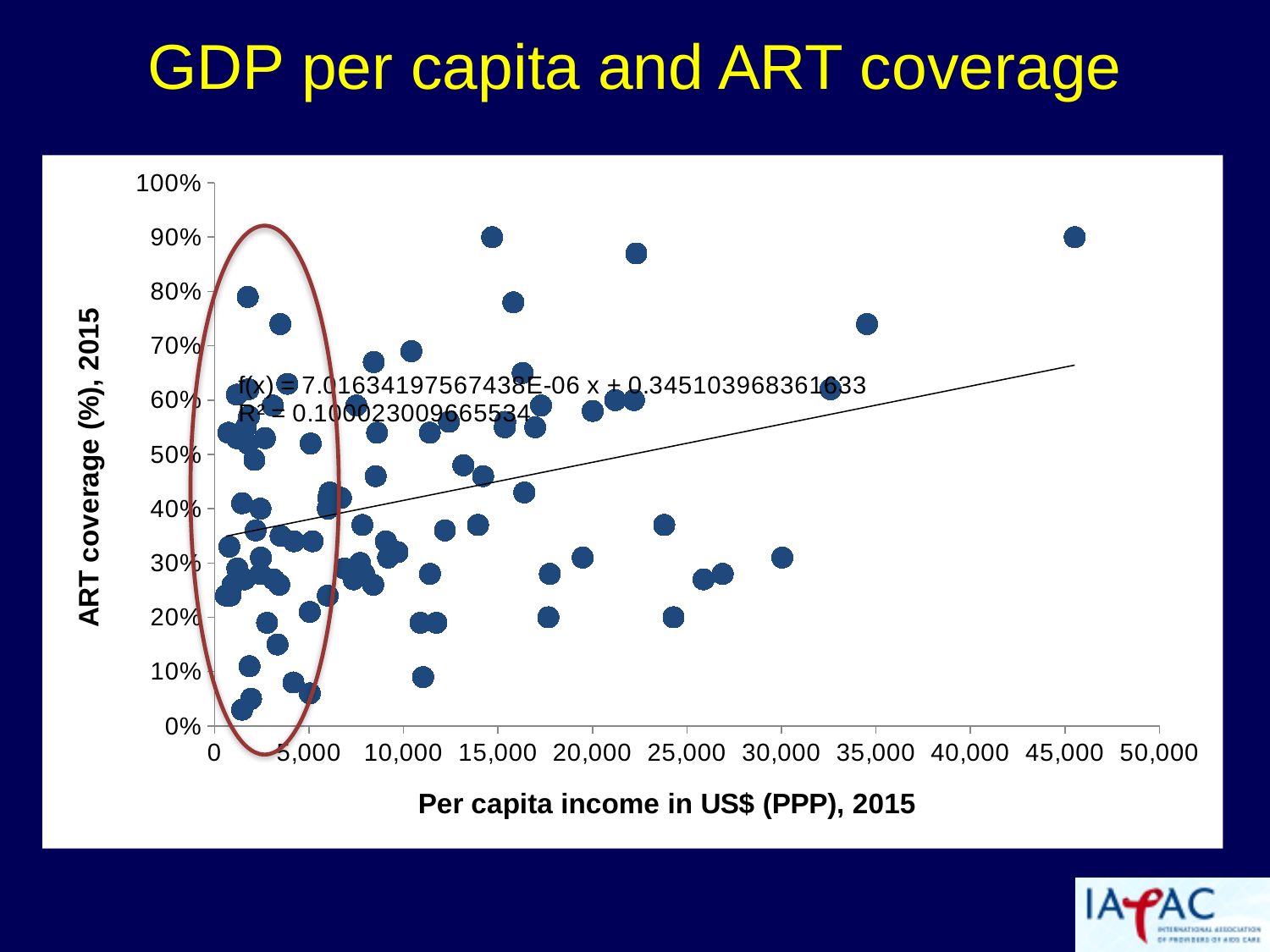
Is the ART coverage of the point with the highest per capita income greater or less than 80%? greater What kind of chart is shown on the slide? scatter chart Is the per capita income of the rightmost point greater or less than 40,000? greater Is the highest ART coverage value plotted greater or less than 80%? greater Does the fitted trend line rise or fall as per capita income increases? rises What is the slope of the fitted line f(x) printed on the chart? 7.01634197567438E-06 What is the intercept of the fitted line f(x) printed on the chart? 0.345103968361633 What R² value is printed on the chart? 0.100023009665534 What is the label of the x axis? Per capita income in US$ (PPP), 2015 What is the title of the chart? GDP per capita and ART coverage